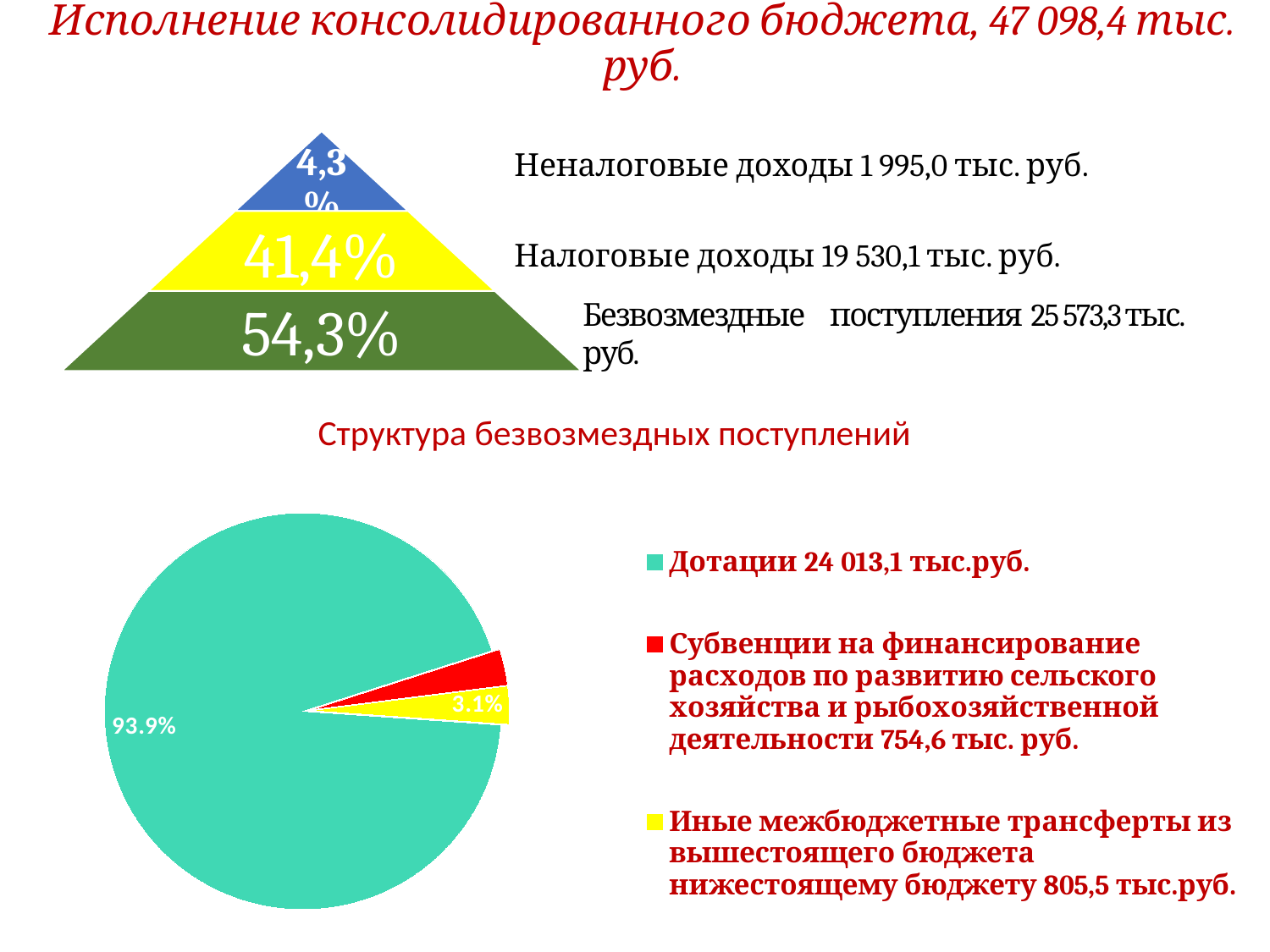
In the pie chart 'Структура безвозмездных поступлений', which category has the largest value? Дотации In the pie chart 'Структура безвозмездных поступлений', which is larger: Иные межбюджетные трансферты or Субвенции? Иные межбюджетные трансферты In the pie chart 'Структура безвозмездных поступлений', what is the difference between Иные межбюджетные трансферты (805,5) and Субвенции (754,6) in тыс. руб.? 50,9 In the pie chart 'Структура безвозмездных поступлений', what share is shown for the Дотации slice? 93.9% How many categories does the legend of the pie chart 'Структура безвозмездных поступлений' list? 3 In the pyramid diagram at the top of the slide, what percentage is shown for Безвозмездные поступления (the bottom green layer)? 54,3% In the pie chart 'Структура безвозмездных поступлений', what amount is given in the legend for Иные межбюджетные трансферты из вышестоящего бюджета нижестоящему бюджету? 805,5 тыс.руб. In the pie chart 'Структура безвозмездных поступлений', which category has the smallest value? Субвенции на финансирование расходов по развитию сельского хозяйства и рыбохозяйственной деятельности In the pie chart 'Структура безвозмездных поступлений', what amount is given in the legend for Дотации? 24 013,1 тыс.руб. In the pie chart 'Структура безвозмездных поступлений', what amount is given in the legend for Субвенции на финансирование расходов по развитию сельского хозяйства и рыбохозяйственной деятельности? 754,6 тыс. руб. In the pie chart 'Структура безвозмездных поступлений', what percentage label is shown on the yellow slice (Иные межбюджетные трансферты)? 3.1% What type of chart is used for 'Структура безвозмездных поступлений'? Pie chart